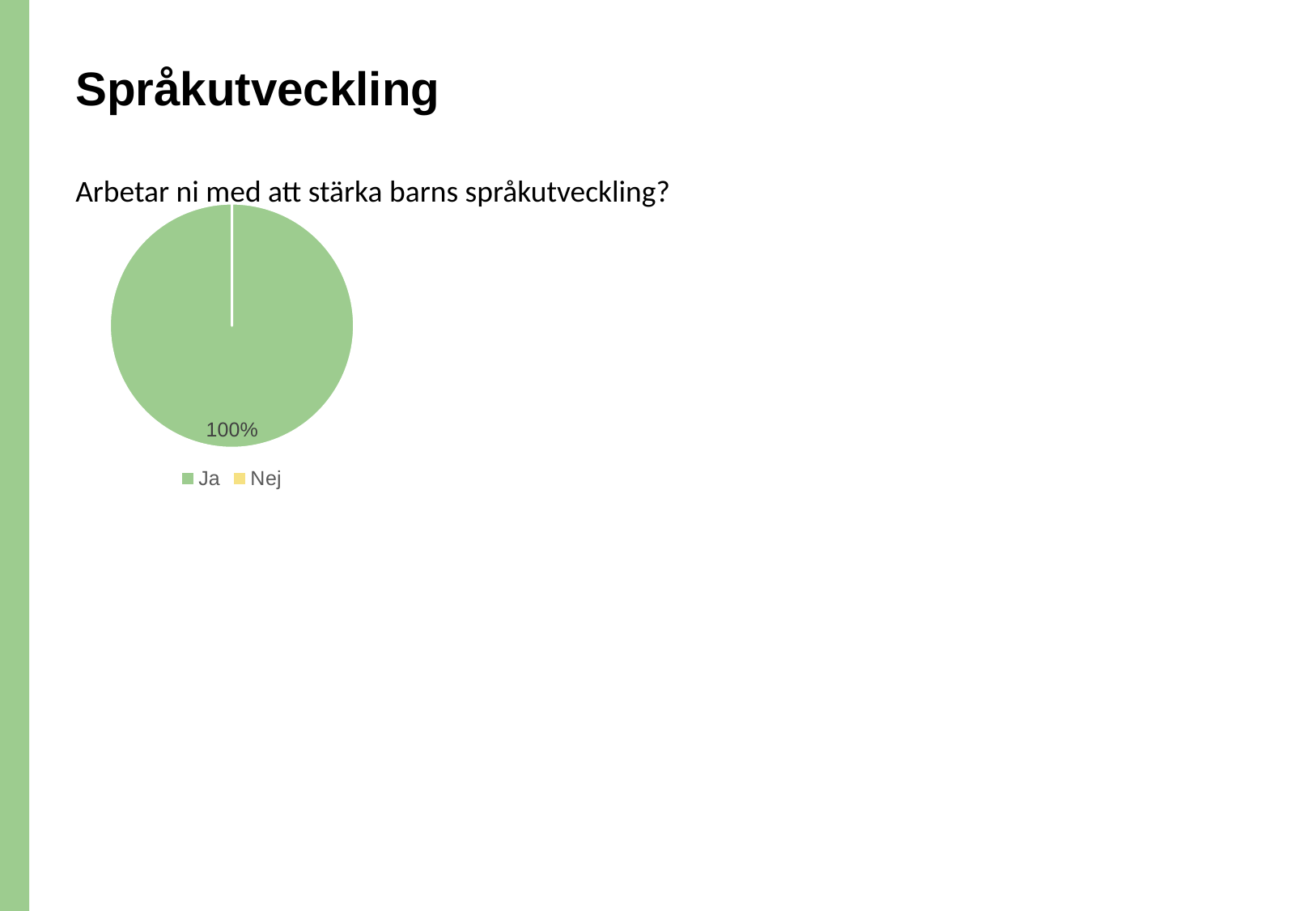
What share of the pie does "Ja" represent? 100% What question does the chart answer, as written above it? Arbetar ni med att stärka barns språkutveckling? What colour represents "Ja" in the legend? green How many categories does the legend list? 2 What kind of chart is shown on the slide? pie chart What is the only data label printed on the pie chart? 100% Which category has the largest share of the pie? Ja Which is larger, the share for "Ja" or the share for "Nej"? Ja Which category has the smallest share of the pie? Nej